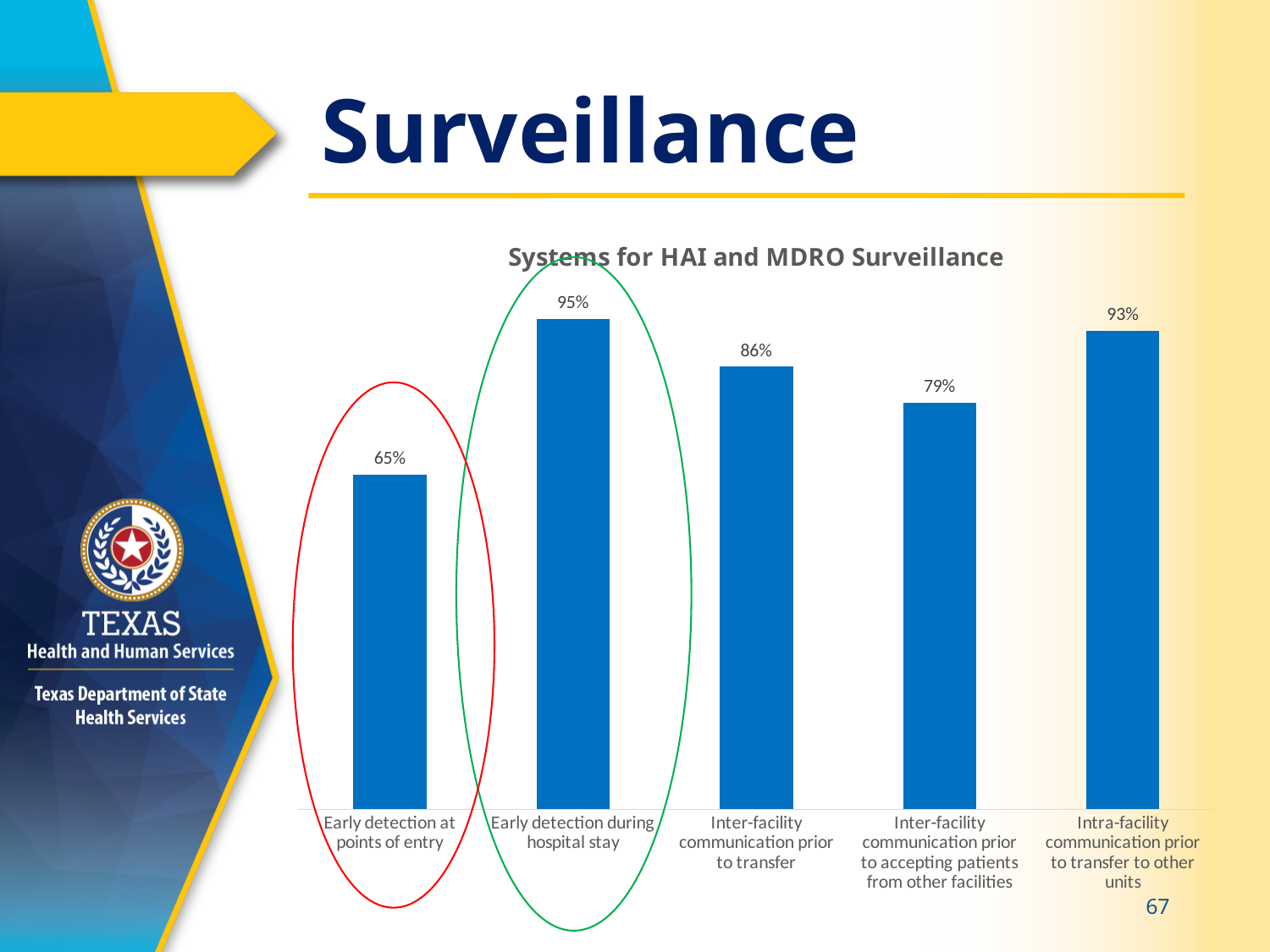
Which is larger: Inter-facility communication prior to transfer or Intra-facility communication prior to transfer to other units? Intra-facility communication prior to transfer to other units How many categories are shown in the chart? 5 Which category has the lowest value? Early detection at points of entry What is the value for Intra-facility communication prior to transfer to other units? 93% What is the difference between Early detection during hospital stay and Early detection at points of entry? 30% What kind of chart is shown on the slide? Bar chart What is the value for Inter-facility communication prior to transfer? 86% What is the value for Early detection at points of entry? 65% What is the value for Inter-facility communication prior to accepting patients from other facilities? 79% What is the title of the chart? Systems for HAI and MDRO Surveillance What is the value for Early detection during hospital stay? 95% Which category has the highest value? Early detection during hospital stay